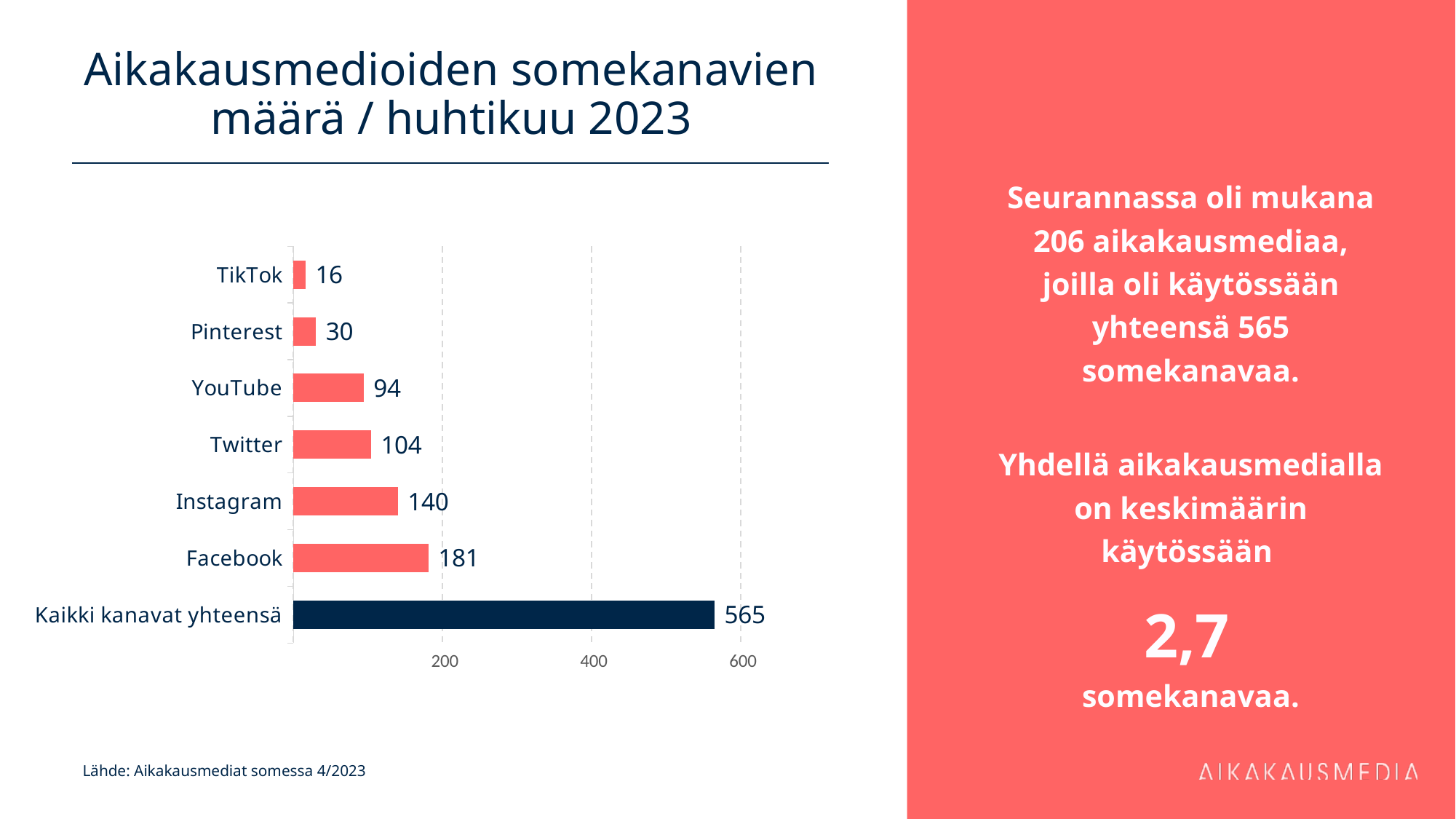
What is the value for Instagram? 140 How many categories are shown in the chart? 7 Which category has the lowest value? TikTok What kind of chart is shown on the slide? Bar chart What is the value for TikTok? 16 What is the value for Facebook? 181 What is the value for Kaikki kanavat yhteensä? 565 What is the title of the chart? Aikakausmedioiden somekanavien määrä / huhtikuu 2023 What is the difference between the values for Facebook and Instagram? 41 Among the individual channels (excluding the total), which has the highest value? Facebook Which is larger, the value for Pinterest or the value for YouTube? YouTube What is the difference between the values for Twitter and YouTube? 10